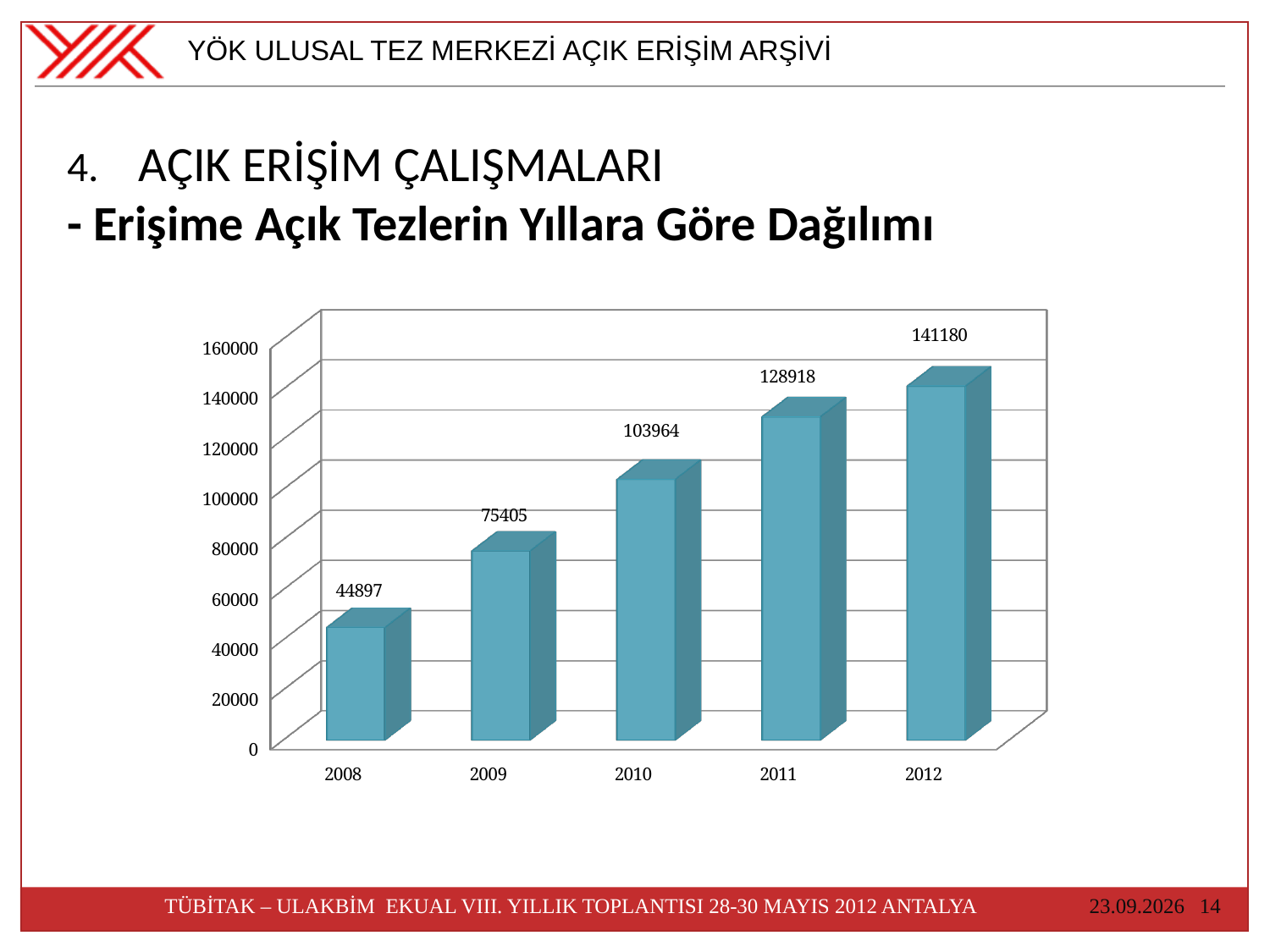
How many years are shown on the x axis? 5 What kind of chart is shown on the slide? bar chart What is the value for 2008? 44897 What is the value for 2012? 141180 Which year has the highest value? 2012 What is the difference between the values for 2012 and 2011? 12262 What is the value for 2010? 103964 Which year has the lowest value? 2008 Is the value for 2011 greater or less than 120000? greater What is the difference between the values for 2009 and 2008? 30508 Do the values rise or fall from 2008 to 2012? rise Which is larger, the value for 2010 or the value for 2009? 2010